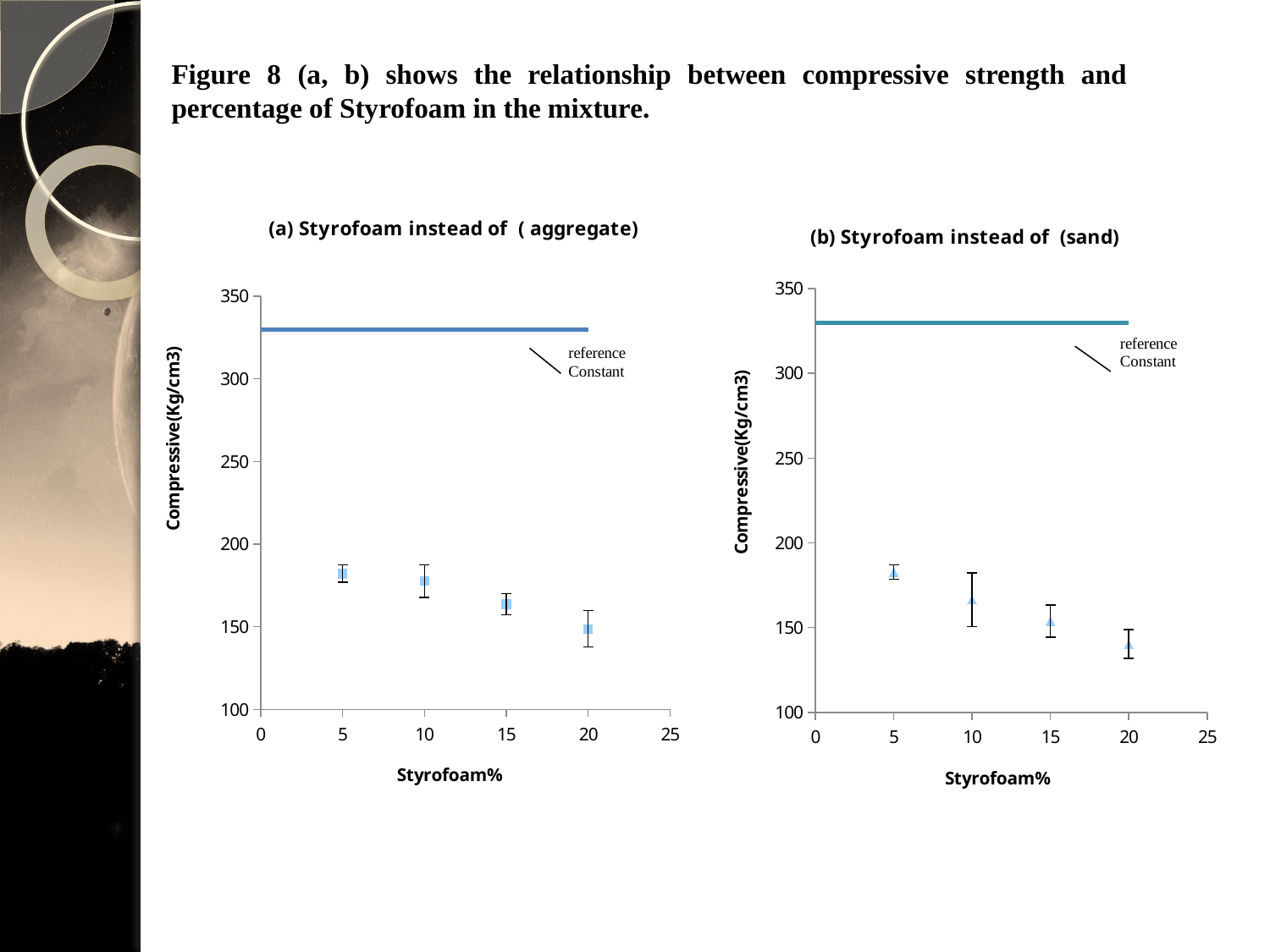
In chart (b) Styrofoam instead of (sand), is the compressive strength at 20% Styrofoam greater or less than 150? less In chart (a) Styrofoam instead of (aggregate), is the compressive strength at 15% Styrofoam greater or less than 150? greater In chart (a) Styrofoam instead of (aggregate), how many Styrofoam% data points are plotted (excluding the reference line)? 4 In chart (b) Styrofoam instead of (sand), is the compressive strength at 10% Styrofoam greater or less than 150? greater What is the y-axis label of chart (b) Styrofoam instead of (sand)? Compressive(Kg/cm3) In chart (b) Styrofoam instead of (sand), which has the larger compressive strength: 5% Styrofoam or 20% Styrofoam? 5% Styrofoam In chart (a) Styrofoam instead of (aggregate), does compressive strength rise or fall as Styrofoam% increases? fall In chart (a) Styrofoam instead of (aggregate), at which Styrofoam% is the compressive strength lowest? 20 In chart (a) Styrofoam instead of (aggregate), what kind of chart is used to plot the data? scatter chart In chart (a) Styrofoam instead of (aggregate), at which Styrofoam% is the compressive strength highest? 5